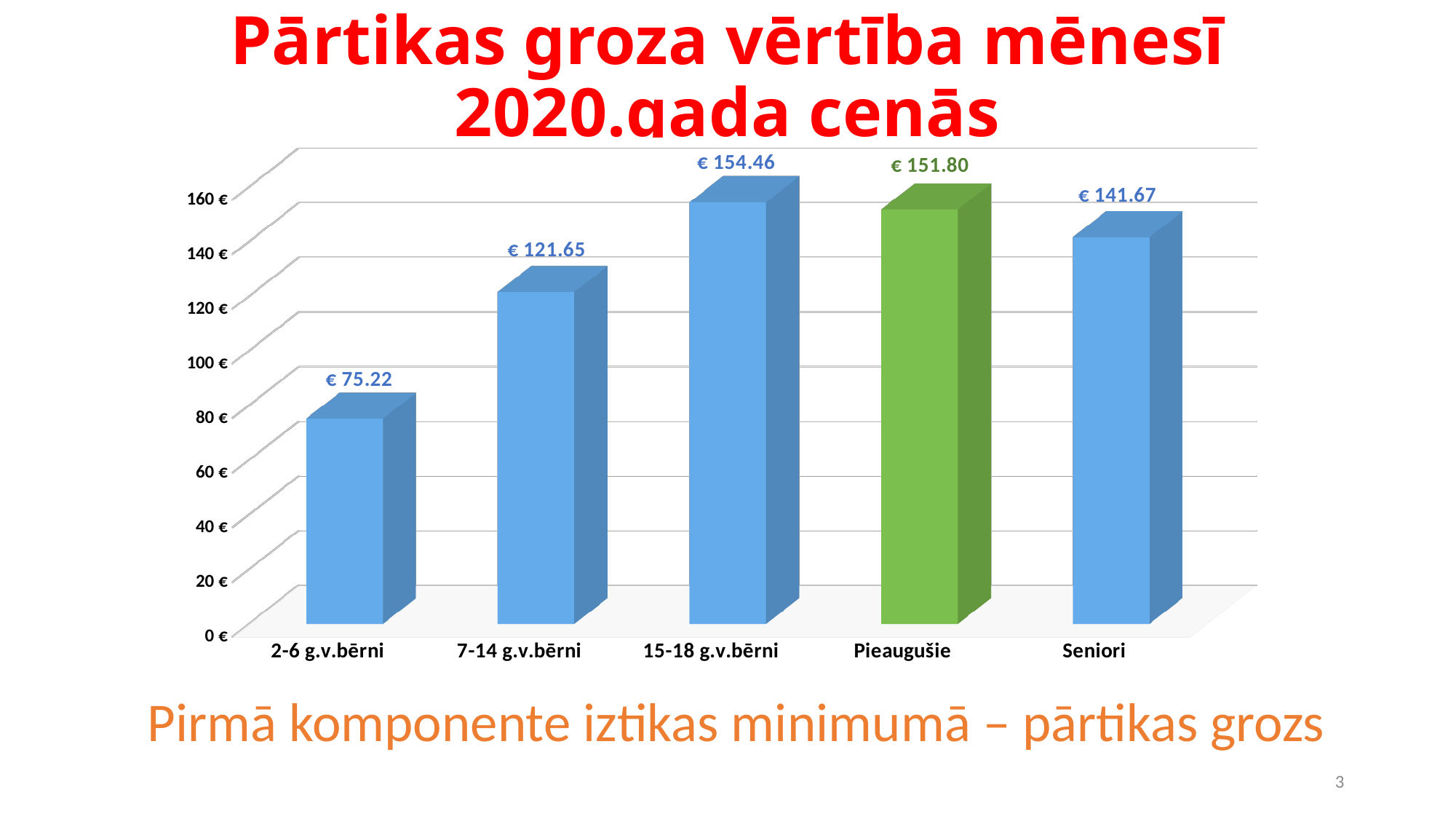
Which is larger, the value for Pieaugušie or the value for Seniori? Pieaugušie Which category's bar is coloured green? Pieaugušie Is the value for 7-14 g.v.bērni greater or less than 100 €? greater How many categories are shown on the x axis? 5 Which category has the lowest value? 2-6 g.v.bērni What is the difference between the values for 15-18 g.v.bērni and Pieaugušie? € 2.66 Which category has the highest value? 15-18 g.v.bērni What is the value for Seniori? € 141.67 What is the value for 2-6 g.v.bērni? € 75.22 What kind of chart is shown on the slide? bar chart What is the difference between the values for 7-14 g.v.bērni and 2-6 g.v.bērni? € 46.43 What is the value for Pieaugušie? € 151.80